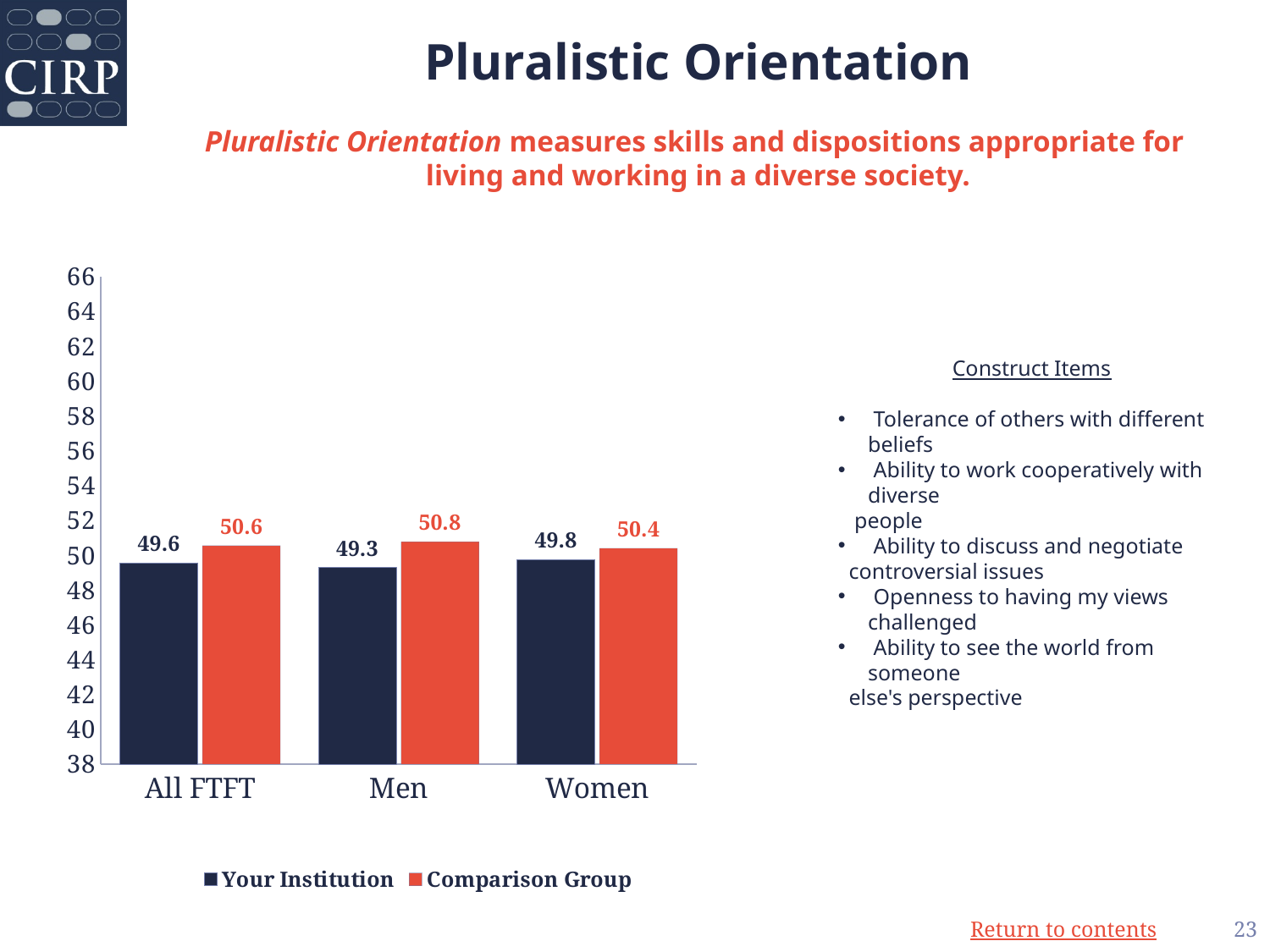
What is the value for Your Institution in the All FTFT category? 49.6 Which category has the highest value for the Comparison Group series? Men How many categories are shown on the x axis? 3 What is the value for Comparison Group in the Men category? 50.8 What is the difference between the Comparison Group and Your Institution values in the Men category? 1.5 How many series does the legend list? 2 Is the value for Your Institution in the Men category greater or less than 50? less What is the value for Comparison Group in the Women category? 50.4 What is the value for Your Institution in the Women category? 49.8 In the All FTFT category, which series has the larger value, Your Institution or Comparison Group? Comparison Group Which category has the lowest value for the Your Institution series? Men What kind of chart is shown on the slide? bar chart